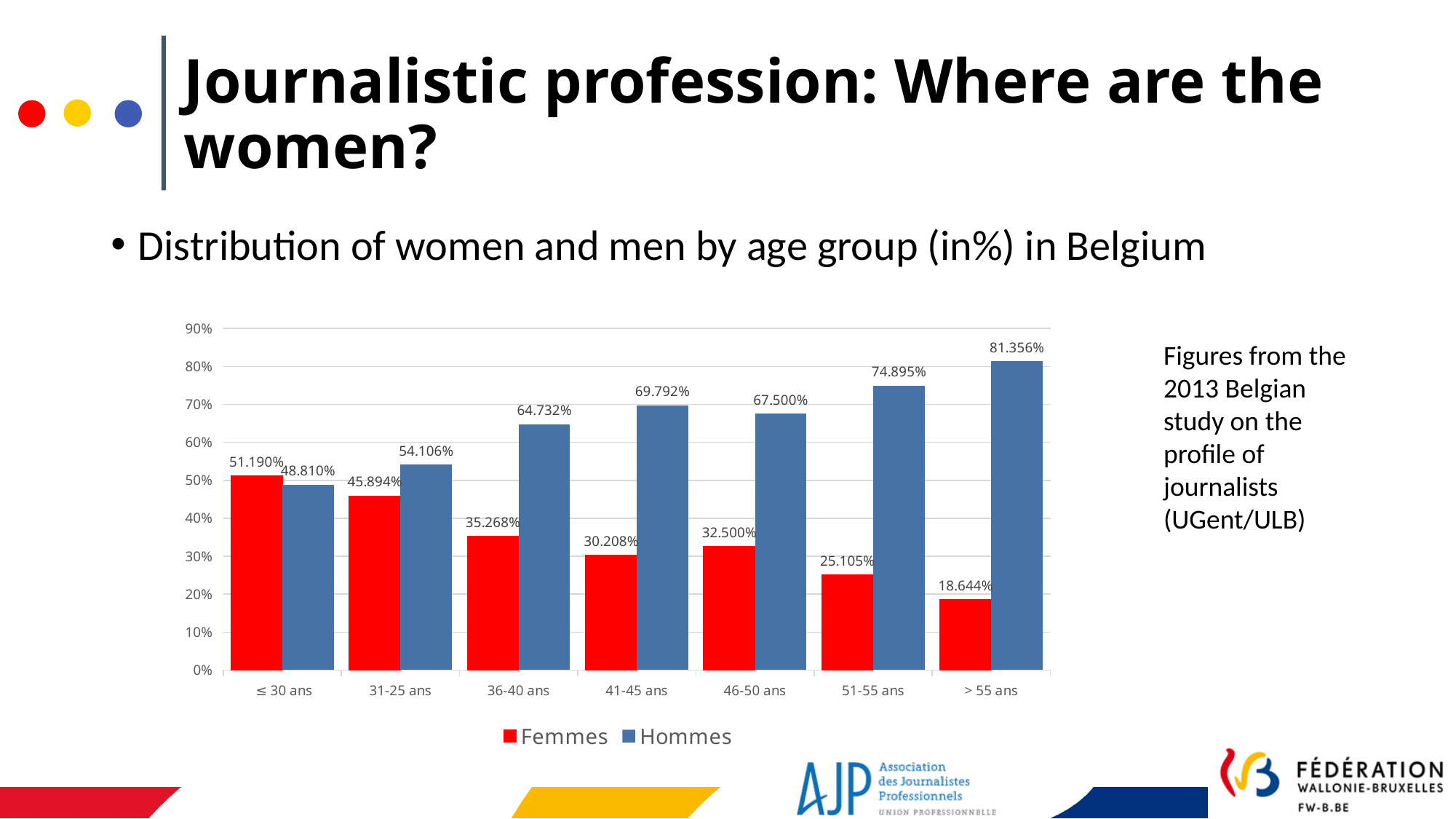
Does the Femmes value generally rise or fall across the age groups from left to right? Fall What is the value for Hommes in the 51-55 ans age group? 74.895% In which age group is the Hommes value highest? > 55 ans What is the value for Femmes in the > 55 ans age group? 18.644% Which colour represents the Hommes series? Blue What is the difference between the Hommes and Femmes values in the > 55 ans age group? 62.712% What is the value for Femmes in the 36-40 ans age group? 35.268% What kind of chart is shown on the slide? Bar chart How many series does the legend list? 2 How many age groups are shown on the x axis? 7 Which is larger in the ≤ 30 ans age group, the Femmes value or the Hommes value? Femmes In which age group is the Femmes value lowest? > 55 ans